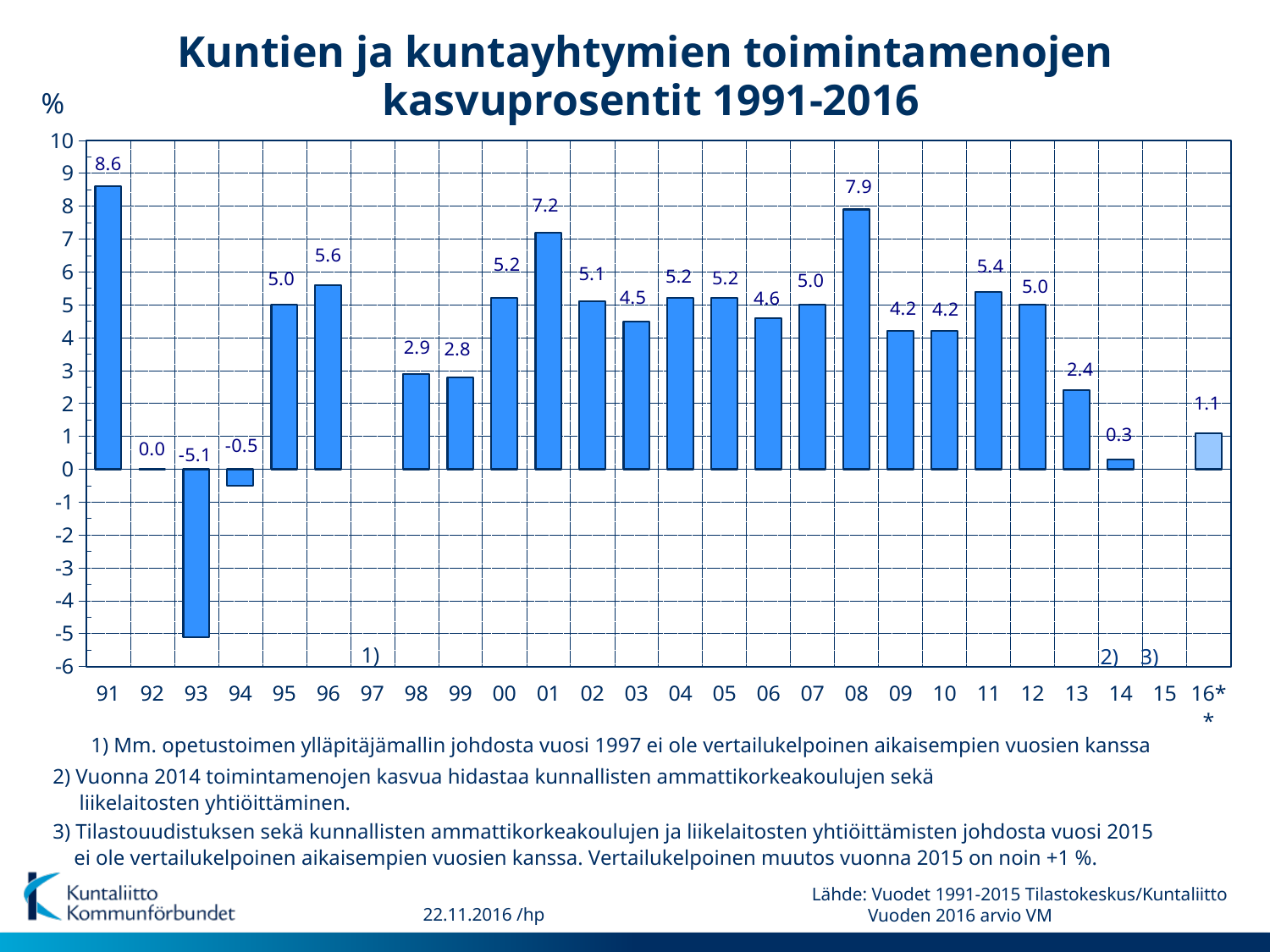
Is the value for 2013 greater or less than 3? less Which two years on the x axis have no bar plotted? 97 and 15 What is the difference between the values for 2001 and 2002? 2.1 Which year has the highest growth percentage? 91 What is the value shown for 2016*? 1.1 Which year has the lowest growth percentage? 93 What is the value shown for 1993? -5.1 Do the values rise or fall from 2011 to 2014? fall What type of chart is shown on the slide? bar chart What value is shown for the year 2008? 7.9 What is the growth percentage shown for 1991? 8.6 Which year has the larger value, 1996 or 2011? 96